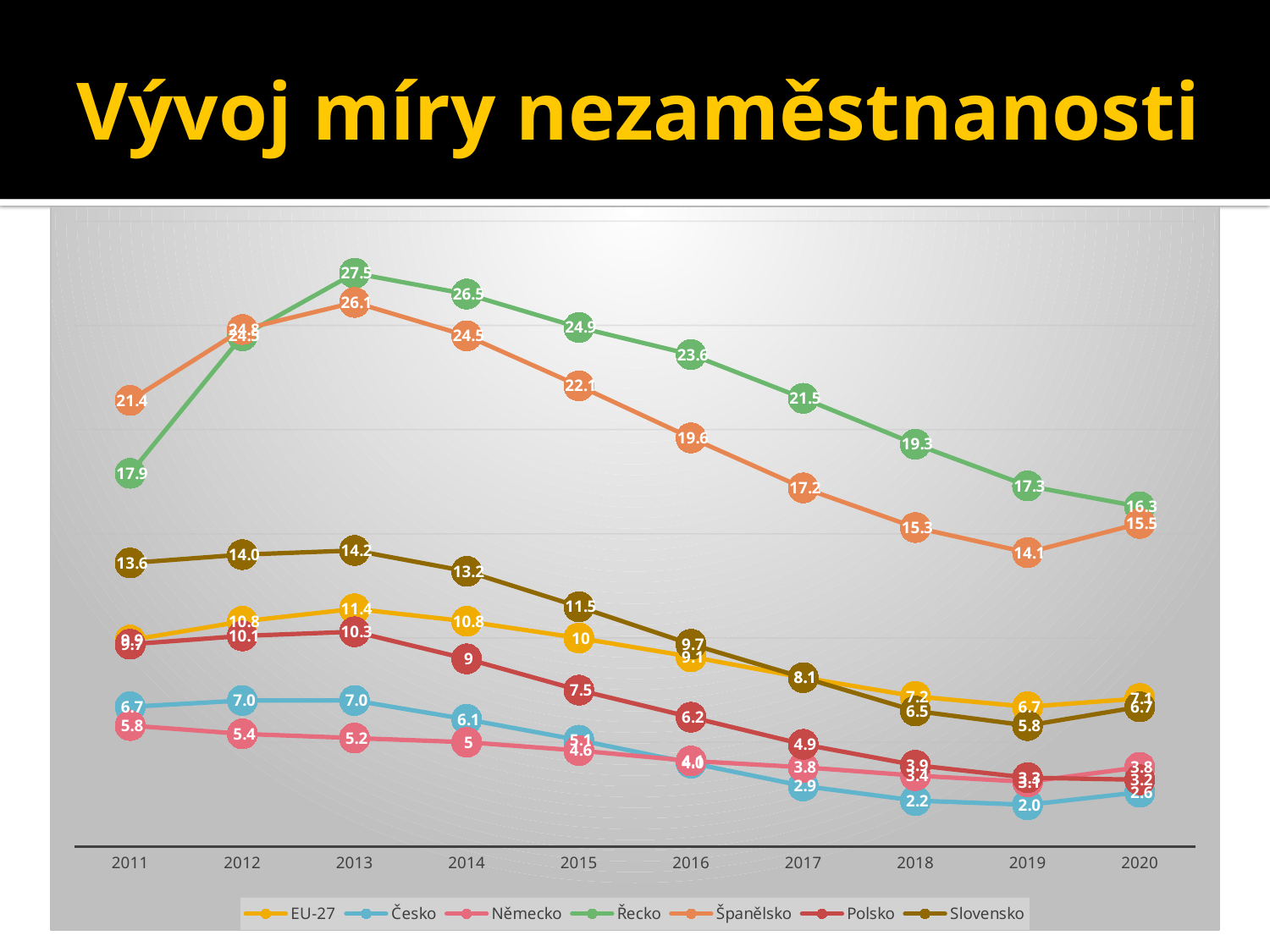
What is the unemployment rate for Řecko in 2013? 27.5 In which year does Řecko reach its highest value? 2013 Which country has the lowest value in 2019? Česko What is the value for Polsko in 2014? 9 What is the difference between Řecko and Španělsko in 2013? 1.4 Which is larger in 2011, the value for Řecko or for Španělsko? Španělsko What kind of chart is shown on the slide? line chart What is the value for Španělsko in 2011? 21.4 How many series does the legend list? 7 How many years are shown on the x axis? 10 What is the value for Slovensko in 2013? 14.2 What is the value for Česko in 2019? 2.0